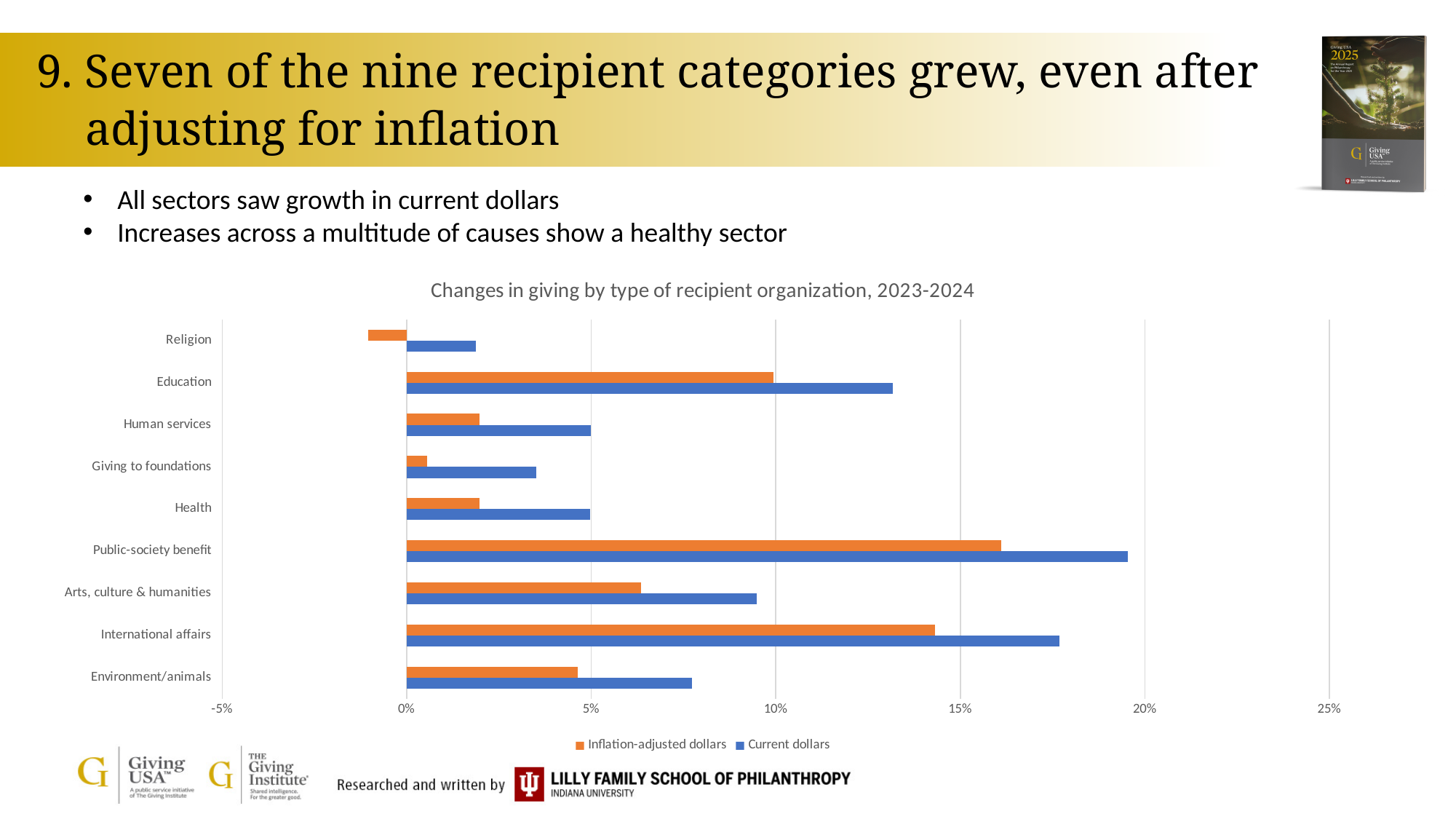
Which recipient category has the lowest value for Current dollars? Religion How many series does the chart's legend list? 2 Which recipient category has the highest value for Current dollars? Public-society benefit Which has the larger Current dollars value, Education or International affairs? International affairs What kind of chart is shown on the slide? Bar chart Is the Current dollars value for Environment/animals greater or less than 10%? less Which recipient category has the lowest value for Inflation-adjusted dollars? Religion Is the Inflation-adjusted dollars value for Public-society benefit greater or less than 15%? greater Which colour represents Inflation-adjusted dollars in the chart? Orange What is the title of the chart? Changes in giving by type of recipient organization, 2023-2024 Is the Current dollars value for Education greater or less than 10%? greater How many recipient categories are plotted on the chart? 9